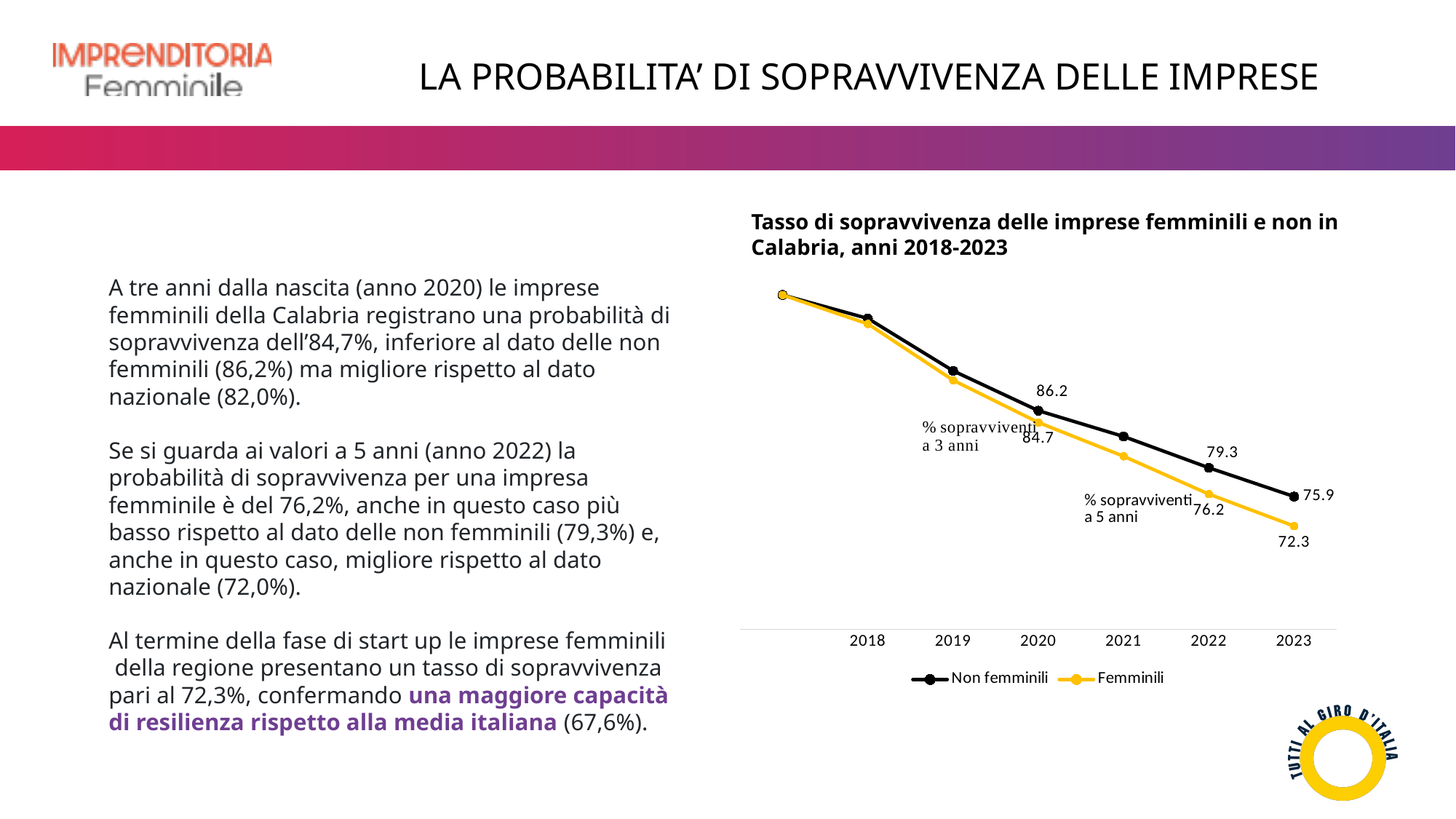
What kind of chart is shown on the slide? Line chart What is the difference between the Non femminili and Femminili values in 2020? 1.5 What is the difference between the Non femminili and Femminili values in 2023? 3.6 In 2022, which series has the larger value, Non femminili or Femminili? Non femminili What is the value for Non femminili in 2023? 75.9 What is the value for Non femminili in 2022? 79.3 What is the value for Femminili in 2022? 76.2 What is the value for Femminili in 2023? 72.3 What is the value for Femminili in 2020? 84.7 Do the values for Femminili rise or fall from 2018 to 2023? Fall How many series does the legend list? 2 What is the value for Non femminili in 2020? 86.2